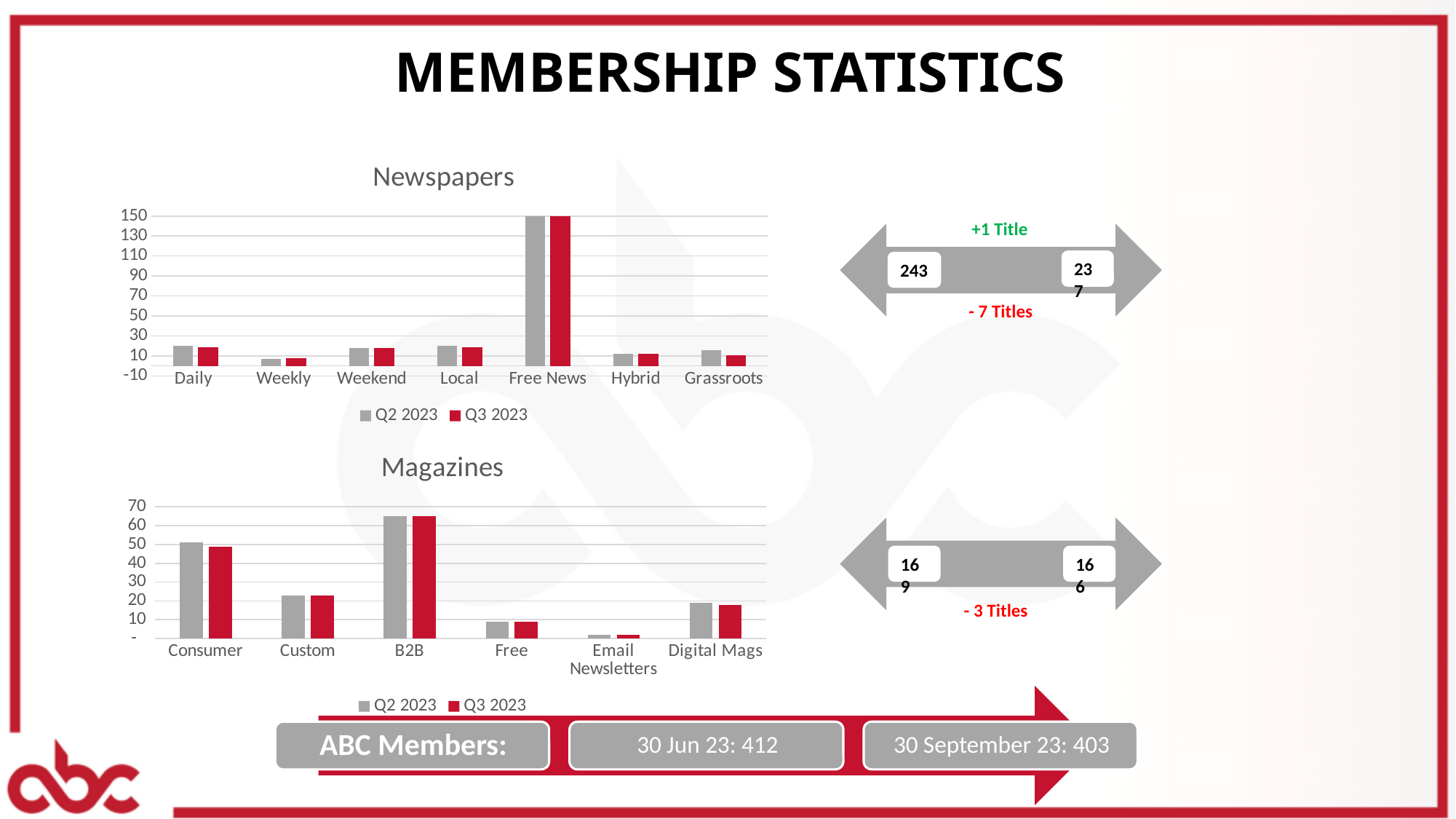
In the Newspapers chart, which category has the lowest values? Weekly How many series does the legend of the Magazines chart list? 2 How many categories are shown on the x axis of the Newspapers chart? 7 In the Magazines chart, is the Q3 2023 value for Free greater or less than 20? less In the Newspapers chart, is the Q2 2023 value for Free News greater or less than 110? greater In the Magazines chart, which category has the lowest values? Email Newsletters In the Newspapers chart, which category has the highest values? Free News In the Magazines chart, is the Q2 2023 value for Consumer greater or less than 40? greater In the Magazines chart, which is larger: the Q3 2023 value for Custom or the Q3 2023 value for Digital Mags? Custom In the Magazines chart, which category has the highest values? B2B What kind of chart is the Newspapers chart? bar chart How many categories are shown on the x axis of the Magazines chart? 6